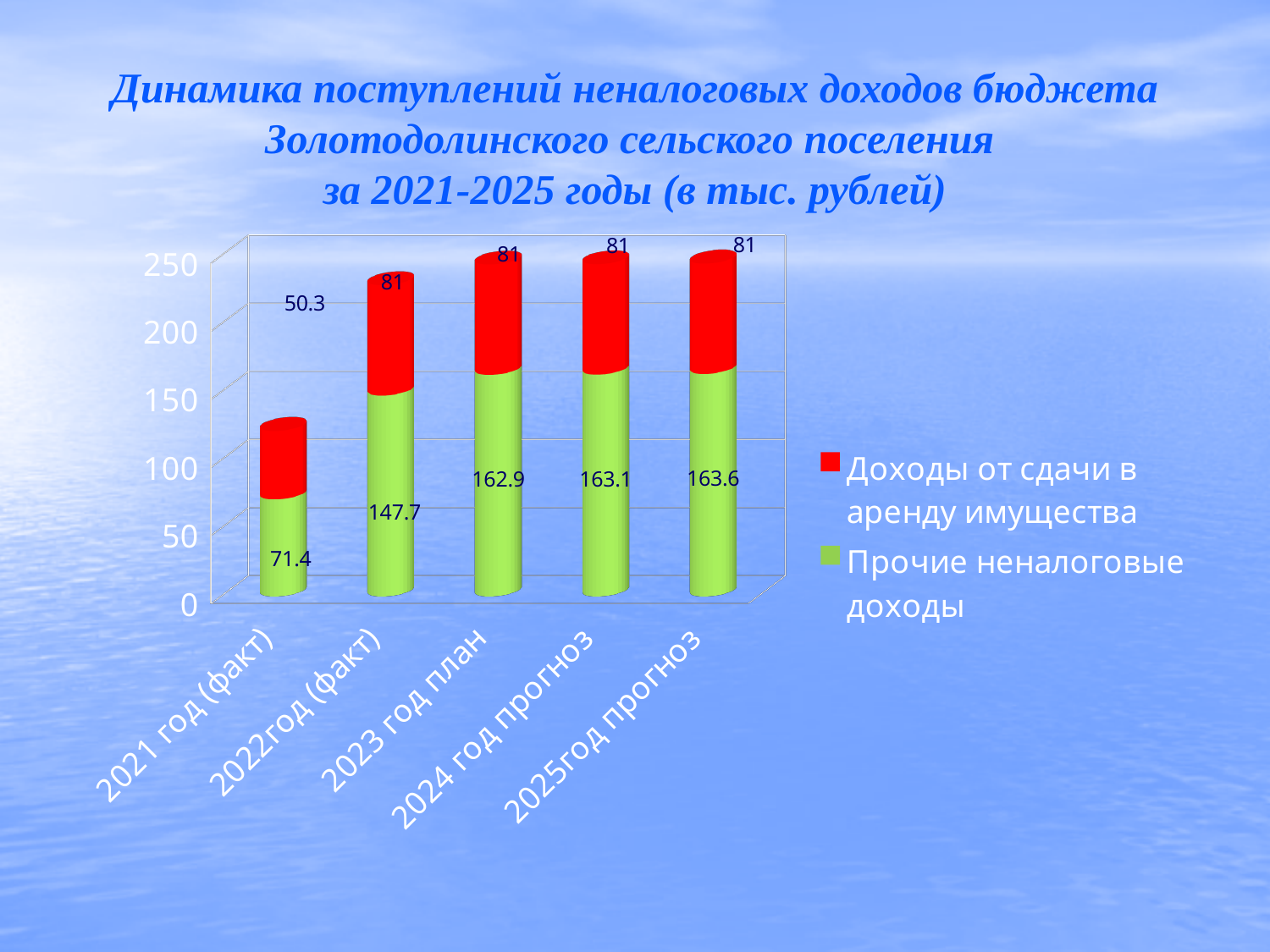
What is the total of the stacked bar for 2021 год (факт)? 121.7 Which category has the lowest value for Прочие неналоговые доходы? 2021 год (факт) How many series does the legend list? 2 Does the value of Прочие неналоговые доходы rise or fall from 2021 год (факт) to 2025год прогноз? rise What is the value of Доходы от сдачи в аренду имущества for 2021 год (факт)? 50.3 What is the value of Прочие неналоговые доходы for 2023 год план? 162.9 What type of chart is shown on the slide? bar chart How many categories are shown on the x axis? 5 What is the value of Прочие неналоговые доходы for 2021 год (факт)? 71.4 What is the value of Доходы от сдачи в аренду имущества for 2025год прогноз? 81 Which category has the highest value for Прочие неналоговые доходы? 2025год прогноз What is the difference between Прочие неналоговые доходы for 2022год (факт) and 2021 год (факт)? 76.3